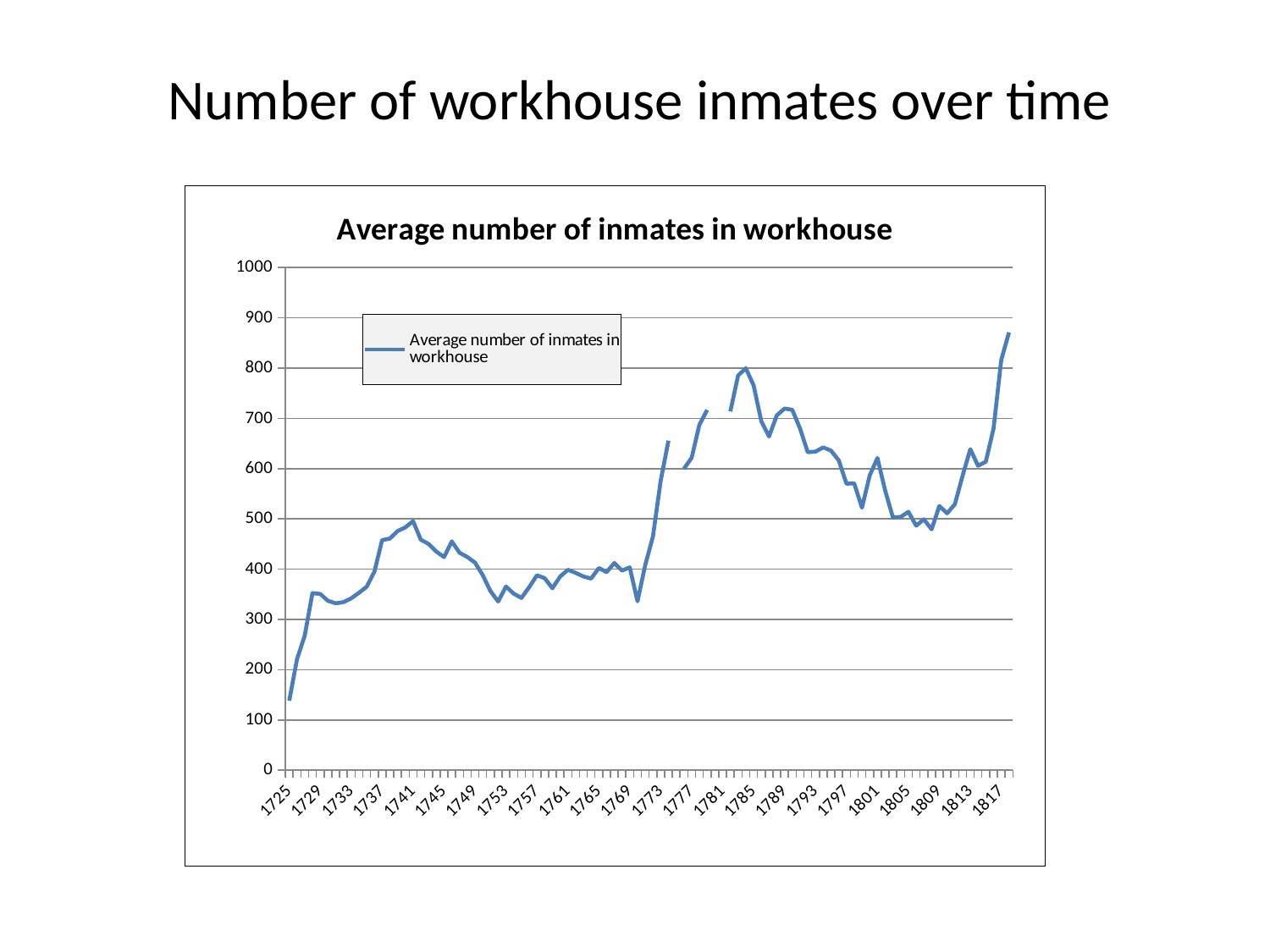
What is the title of the chart? Average number of inmates in workhouse What kind of chart is shown on the slide? line chart Is the value for 1737 greater or less than 400? greater Is the value for 1817 greater or less than 800? greater Which year has the lowest average number of inmates? 1725 Is the value for 1813 greater or less than 600? greater How many series does the legend list? 1 What colour is the plotted line? blue Which is larger, the value for 1785 or the value for 1745? 1785 Which year has the highest average number of inmates? 1818